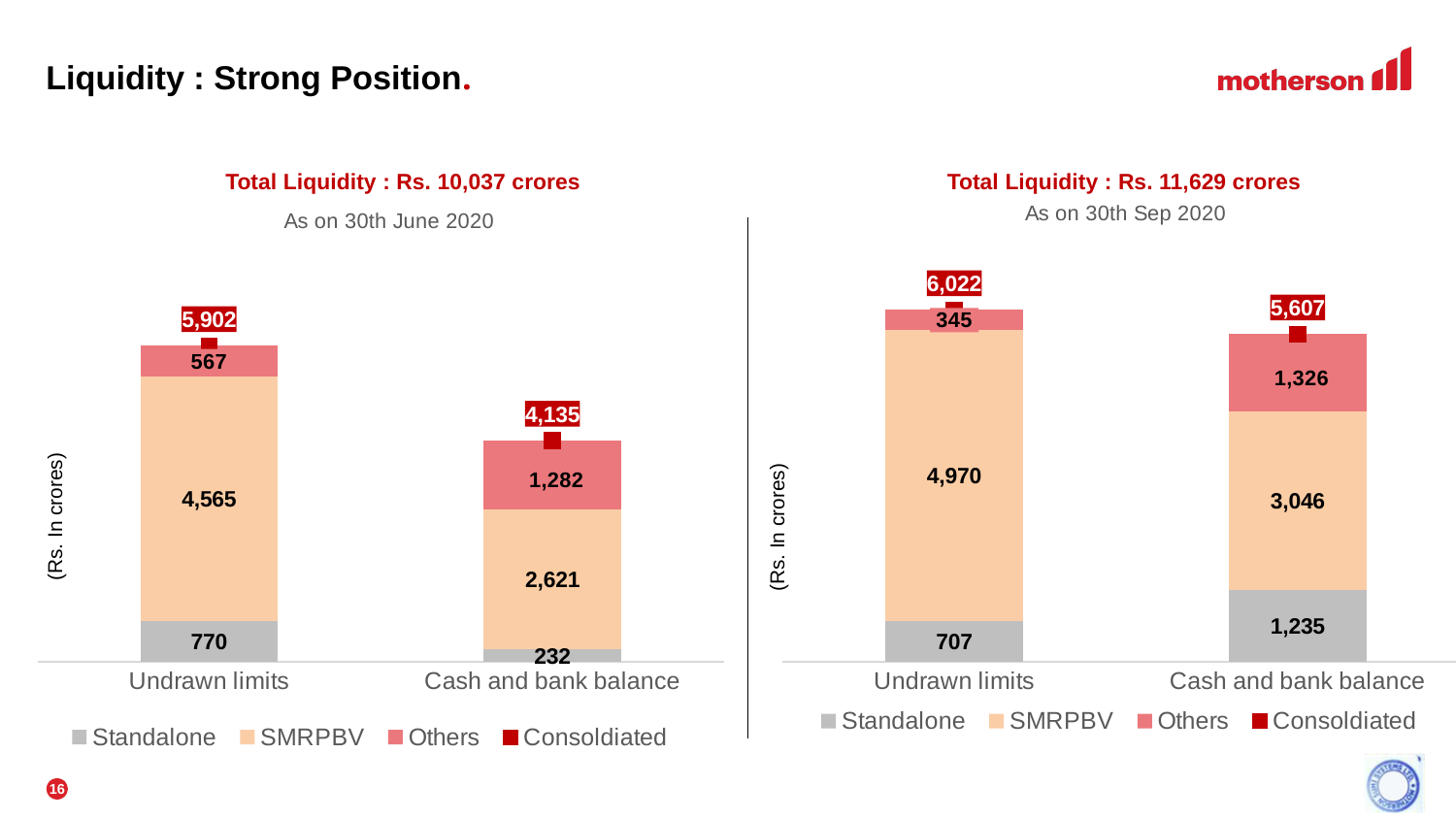
In the chart as on 30th Sep 2020, what is the Standalone value for Undrawn limits? 707 In the chart as on 30th Sep 2020, what is the difference between the SMRPBV values for Undrawn limits and Cash and bank balance? 1,924 In the chart as on 30th June 2020, what is the Standalone value for Cash and bank balance? 232 In the chart as on 30th June 2020, what is the consolidated total of the Undrawn limits bar? 5,902 In the chart as on 30th June 2020, which category has the larger Others value, Undrawn limits or Cash and bank balance? Cash and bank balance How many series does the legend of the chart as on 30th June 2020 list? 4 In the chart as on 30th Sep 2020, what is the consolidated total of the Cash and bank balance bar? 5,607 In the chart as on 30th June 2020, what is the SMRPBV value for Undrawn limits? 4,565 What total liquidity is stated above the chart as on 30th Sep 2020? Rs. 11,629 crores What kind of chart is the chart as on 30th Sep 2020? Stacked bar chart In the chart as on 30th Sep 2020, which category has the higher consolidated total? Undrawn limits In the chart as on 30th Sep 2020, what is the Others value for Cash and bank balance? 1,326